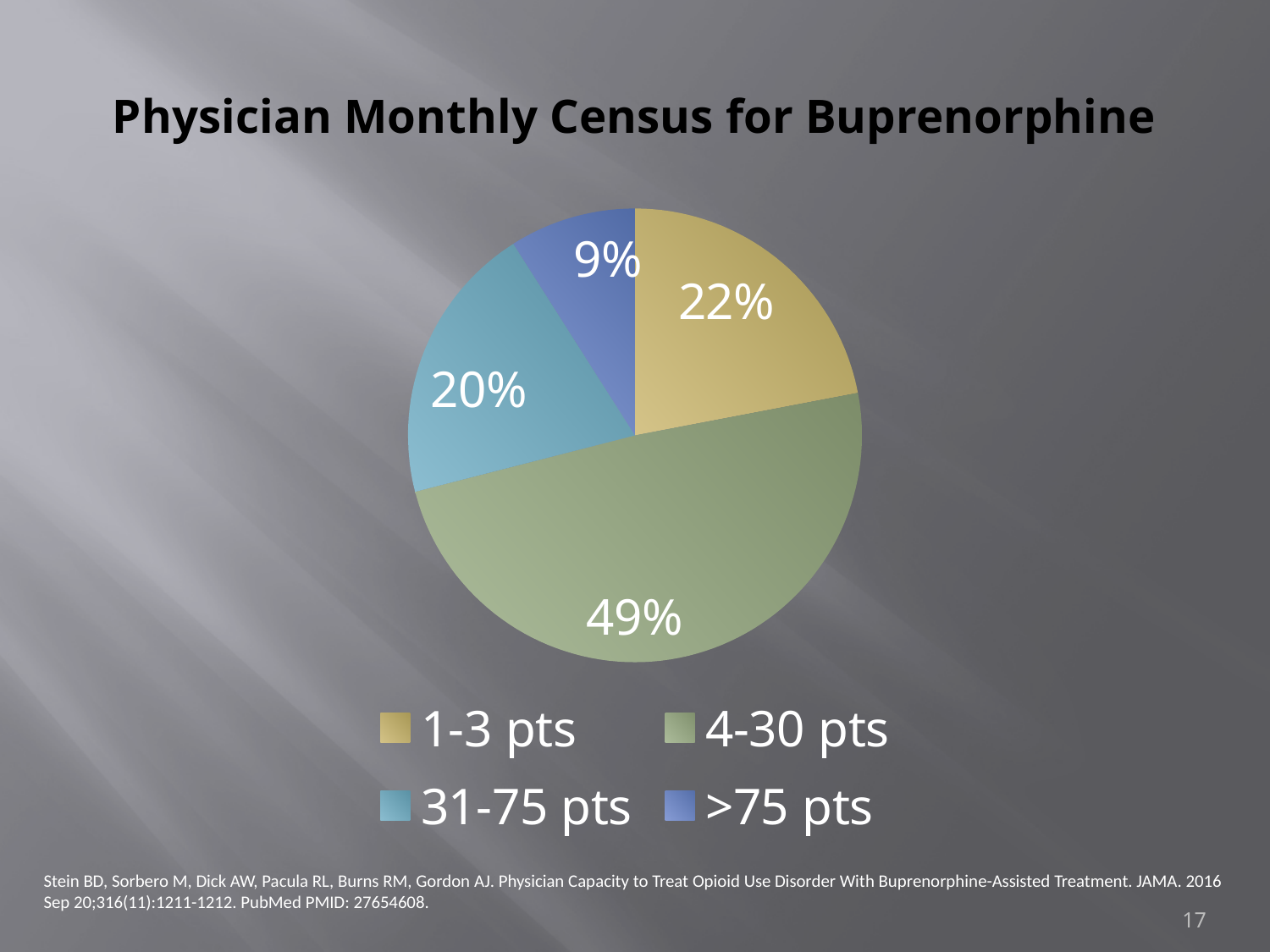
How many categories does the pie chart have? 4 Which category has the smallest slice of the pie? >75 pts What is the difference in percentage points between the 4-30 pts slice and the 1-3 pts slice? 27 Which category is shown in green in the legend? 4-30 pts What kind of chart is shown on the slide? pie chart Which category has the largest slice of the pie? 4-30 pts Which slice is larger, 1-3 pts or 31-75 pts? 1-3 pts What share of the pie does the 4-30 pts slice represent? 49% What share of the pie does the 1-3 pts slice represent? 22% What is the title of the chart? Physician Monthly Census for Buprenorphine What share of the pie does the 31-75 pts slice represent? 20%